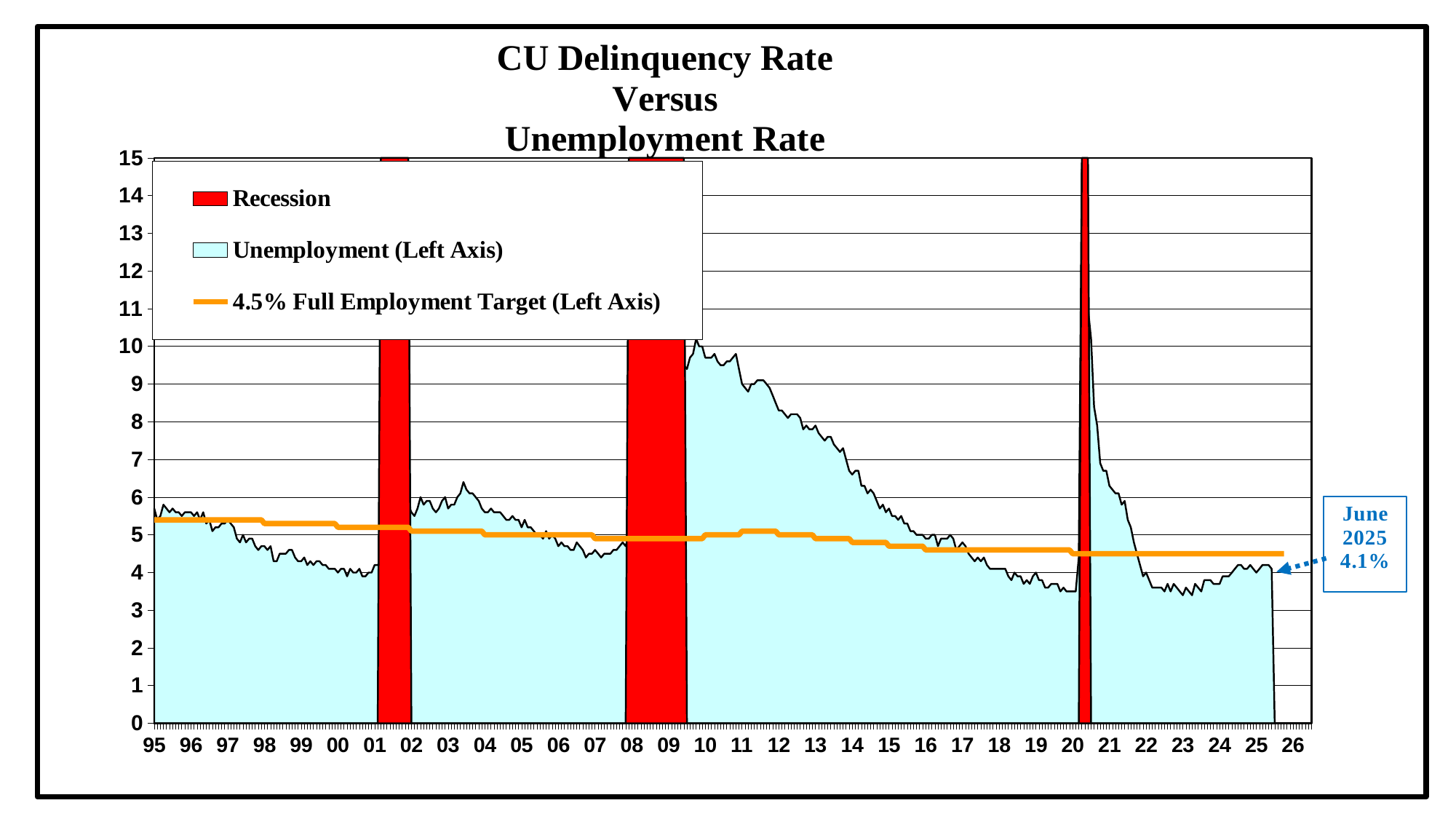
Which year shows the highest unemployment rate on the chart? 2020 Is the unemployment rate in 2000 greater or less than 5? less Is the unemployment rate higher in 2010 or in 2000? 2010 How many recession bands are shaded on the chart? 3 Is the unemployment rate in 2003 greater or less than 5? greater What unemployment rate is annotated for June 2025? 4.1% How many entries does the chart's legend list? 3 Is the unemployment rate in 2010 greater or less than 8? greater What is the title of the chart? CU Delinquency Rate Versus Unemployment Rate Does the unemployment rate rise or fall from 2010 to 2019? fall What value is the Full Employment Target line labelled as in the legend? 4.5%